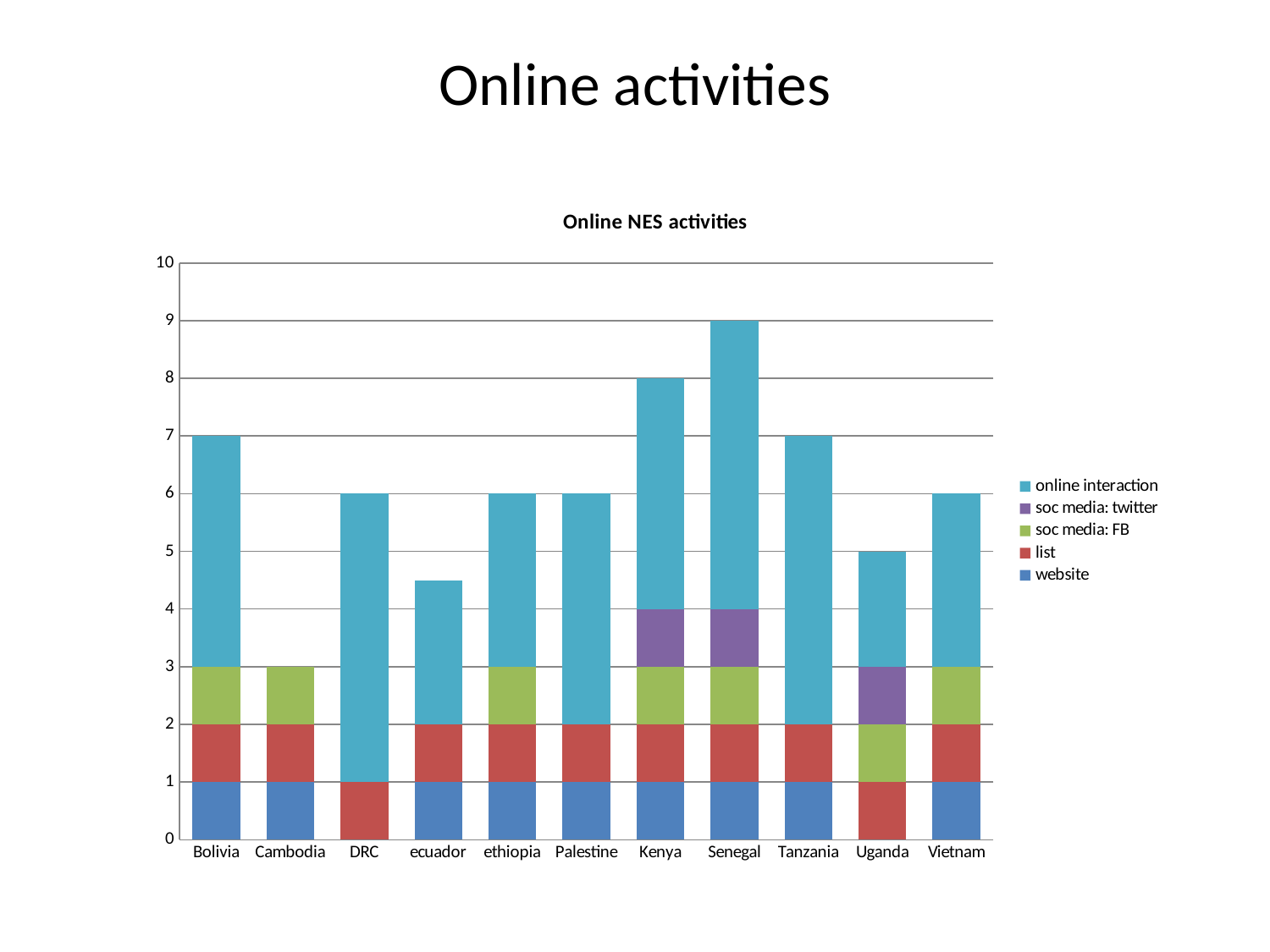
What is the title of the chart? Online NES activities Which series is listed first in the legend? online interaction What is the total height of the stacked bar for Kenya? 8 What is the total height of the stacked bar for Senegal? 9 Which country has the lowest total bar? Cambodia What kind of chart is shown on the slide? stacked bar chart How many series does the legend list? 5 What is the difference between the total for Senegal and the total for Cambodia? 6 How many countries are shown on the x axis? 11 Which has a larger total, Kenya or Tanzania? Kenya Which country has the highest total bar? Senegal Is the total for ecuador greater or less than 5? less